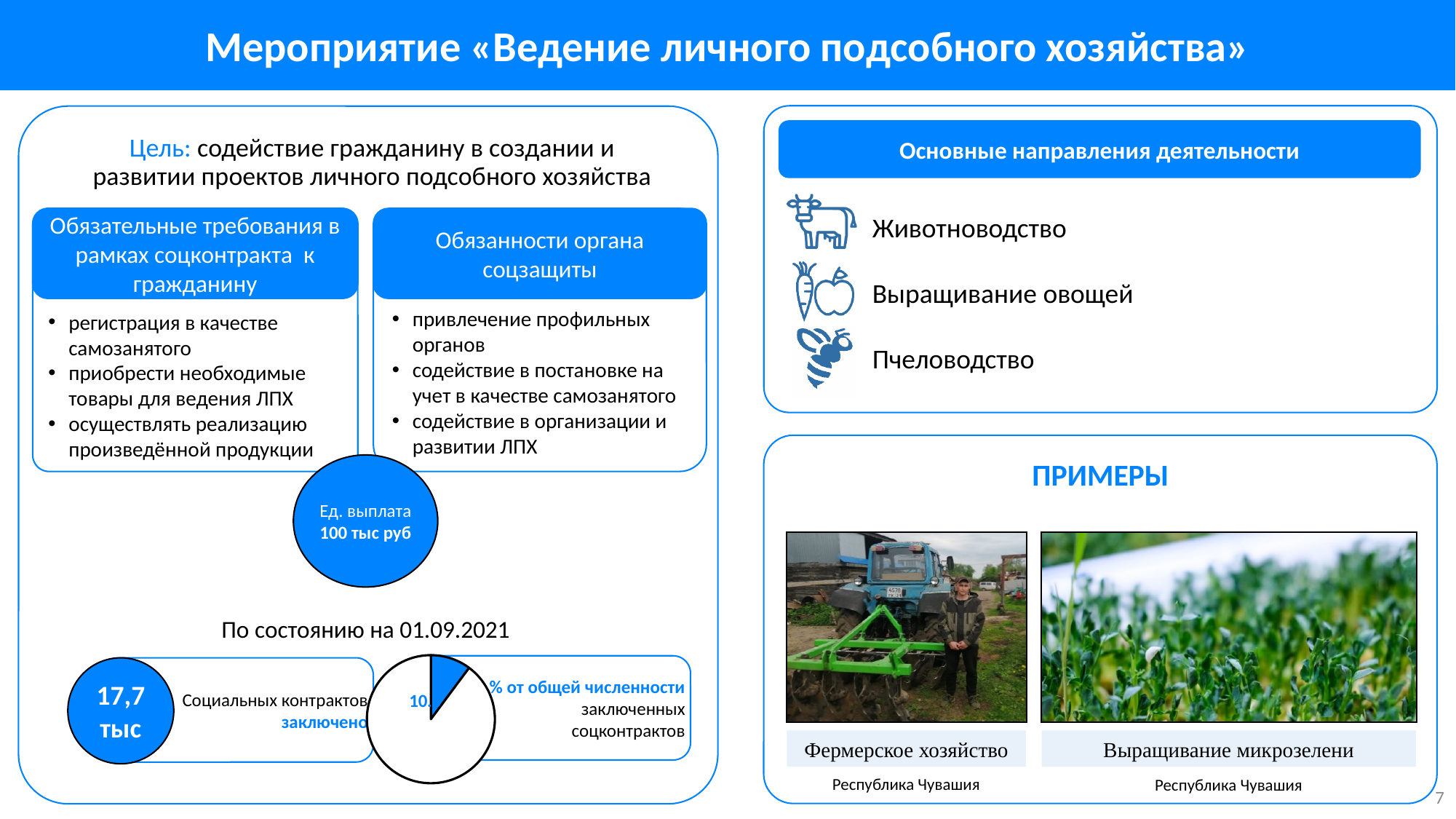
According to the text next to the pie chart at the bottom left, what does the pie chart show a share of? от общей численности заключенных соцконтрактов In the pie chart at the bottom left of the slide, which slice is larger, the blue one or the white one? the white one How many slices does the pie chart at the bottom left of the slide have? 2 In the pie chart at the bottom left of the slide, what colour is the smaller slice? blue What kind of chart is shown at the bottom left of the slide, next to the text '% от общей численности заключенных соцконтрактов'? pie chart Does the blue slice in the pie chart at the bottom left of the slide represent more or less than half of the pie? less